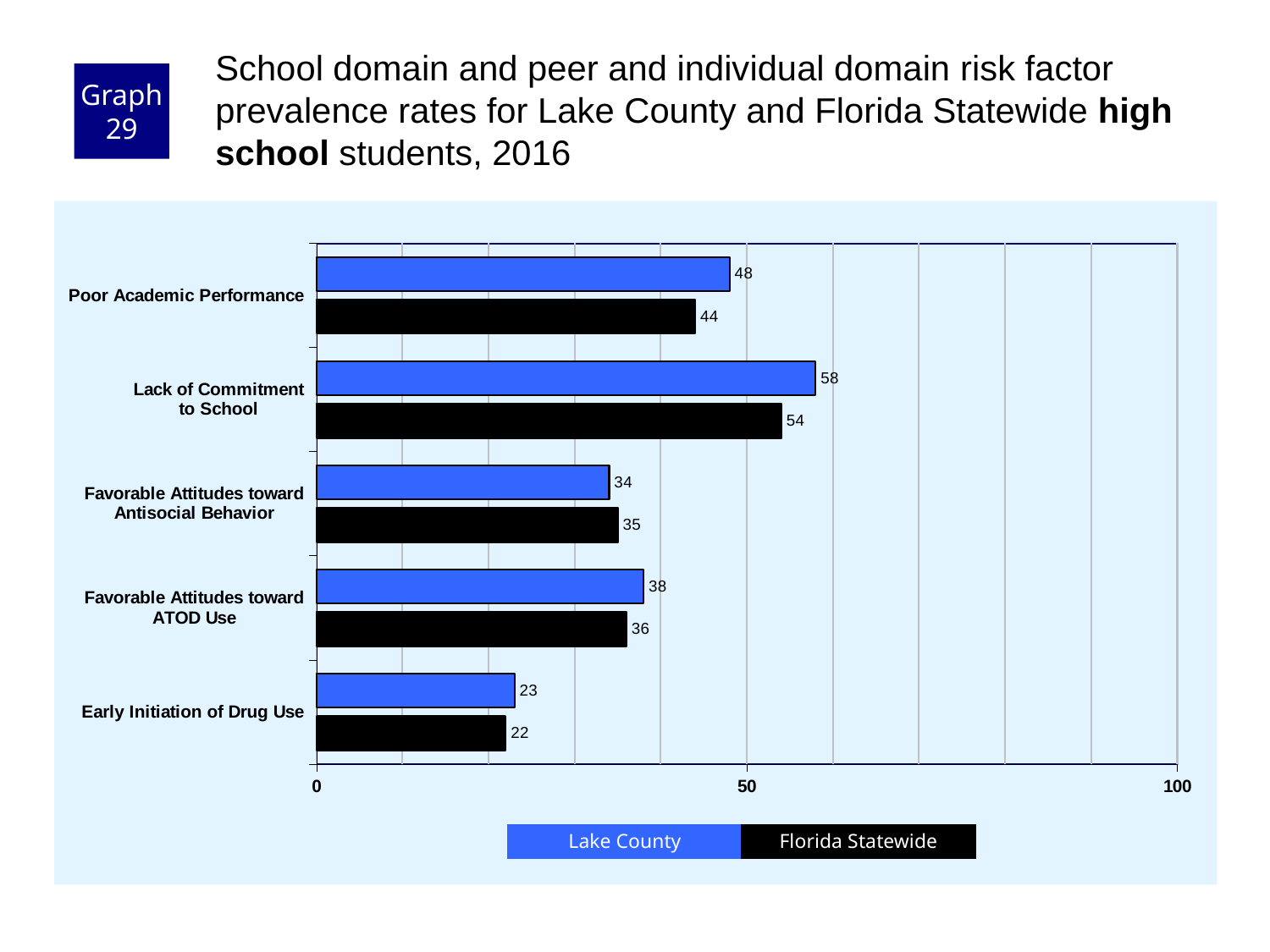
What is the Florida Statewide value for Lack of Commitment to School? 54 Is the Lake County value for Lack of Commitment to School greater or less than 50? greater How many series does the legend list? 2 How many risk factor categories are shown on the chart? 5 What is the Lake County value for Early Initiation of Drug Use? 23 What kind of chart is shown on the slide? bar chart Which risk factor has the lowest Florida Statewide value? Early Initiation of Drug Use What is the difference between the Lake County and Florida Statewide values for Poor Academic Performance? 4 What is the Lake County value for Poor Academic Performance? 48 Which risk factor has the highest Lake County value? Lack of Commitment to School Which colour represents Florida Statewide in the chart? black Which is larger for Favorable Attitudes toward Antisocial Behavior: the Lake County value or the Florida Statewide value? Florida Statewide